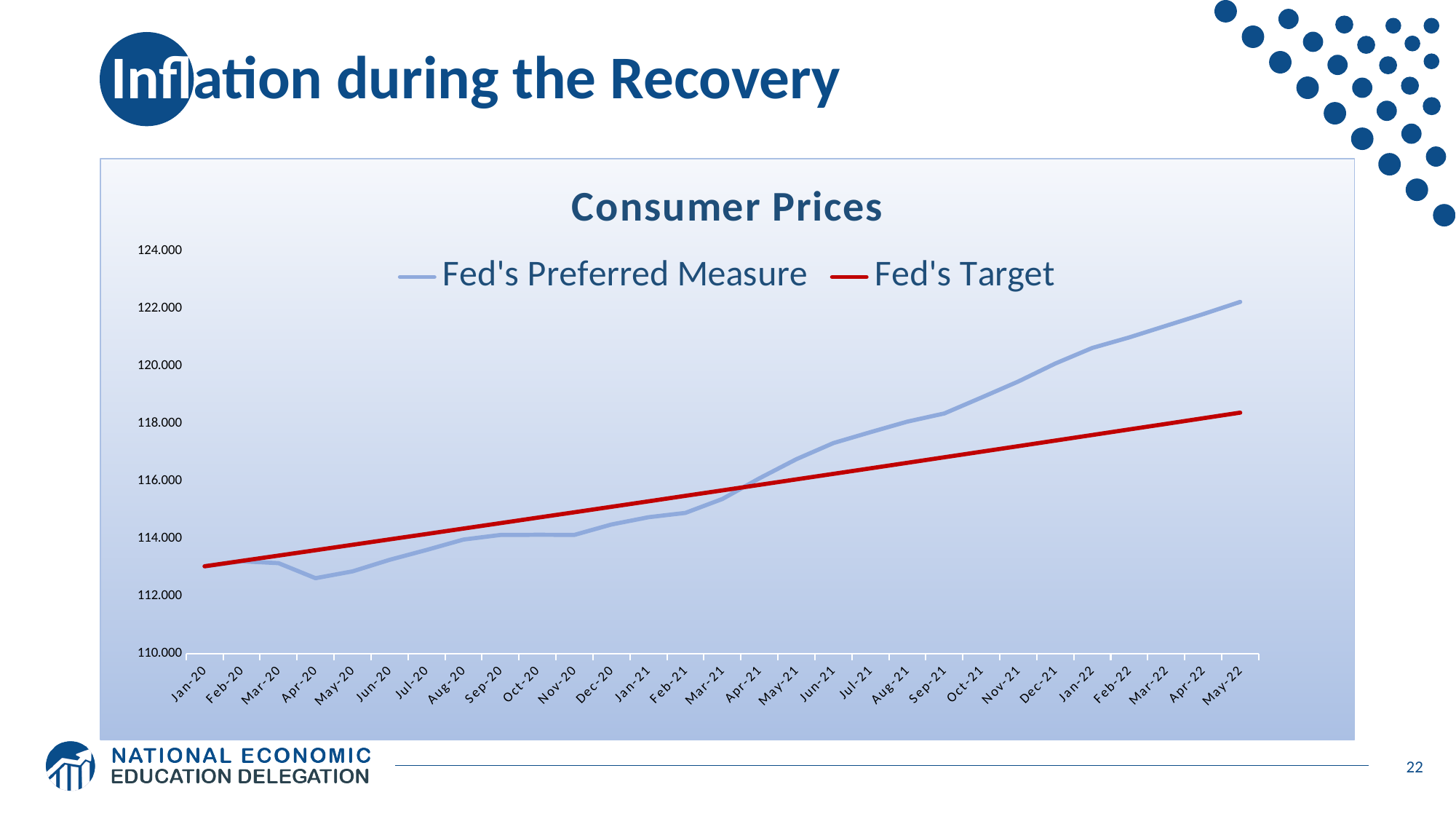
Is the value of Fed's Preferred Measure in May-22 greater or less than 120.000? greater What kind of chart is shown on the slide? line chart Is the value of Fed's Target in May-22 greater or less than 120.000? less Does the Fed's Preferred Measure line generally rise or fall from Jan-20 to May-22? rise How many months are shown on the x axis of the chart? 29 How many series does the legend of the Consumer Prices chart list? 2 What is the title of the chart? Consumer Prices In which month does the Fed's Preferred Measure line reach its lowest value? Apr-20 Which series is drawn in red? Fed's Target Is the value of Fed's Preferred Measure in Apr-20 greater or less than 114.000? less In May-22, which series has the higher value, Fed's Preferred Measure or Fed's Target? Fed's Preferred Measure In which month does the Fed's Preferred Measure line reach its highest value? May-22